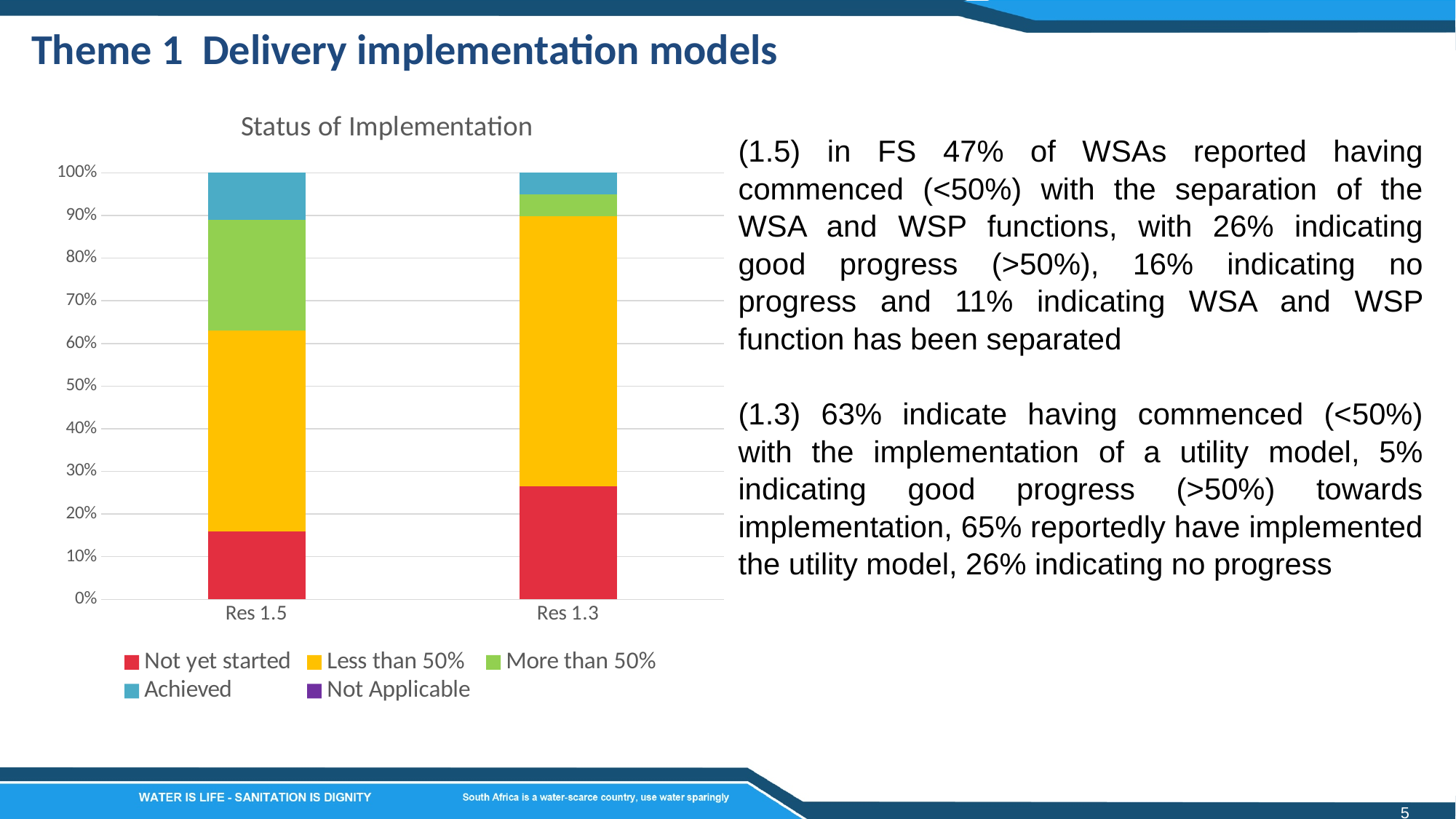
Which category has the larger Not yet started segment, Res 1.5 or Res 1.3? Res 1.3 Is the Achieved segment for Res 1.3 greater or less than 10%? less Is the Less than 50% segment for Res 1.3 greater or less than 50%? greater How many categories are shown on the x axis of the chart? 2 What is the title of the chart? Status of Implementation Is the Not yet started segment for Res 1.3 greater or less than 20%? greater Which category has the larger More than 50% segment, Res 1.5 or Res 1.3? Res 1.5 What kind of chart is shown on the slide? Stacked bar chart How many series does the chart legend list? 5 Which category has the larger Achieved segment, Res 1.5 or Res 1.3? Res 1.5 Which series in the legend is shown in purple? Not Applicable